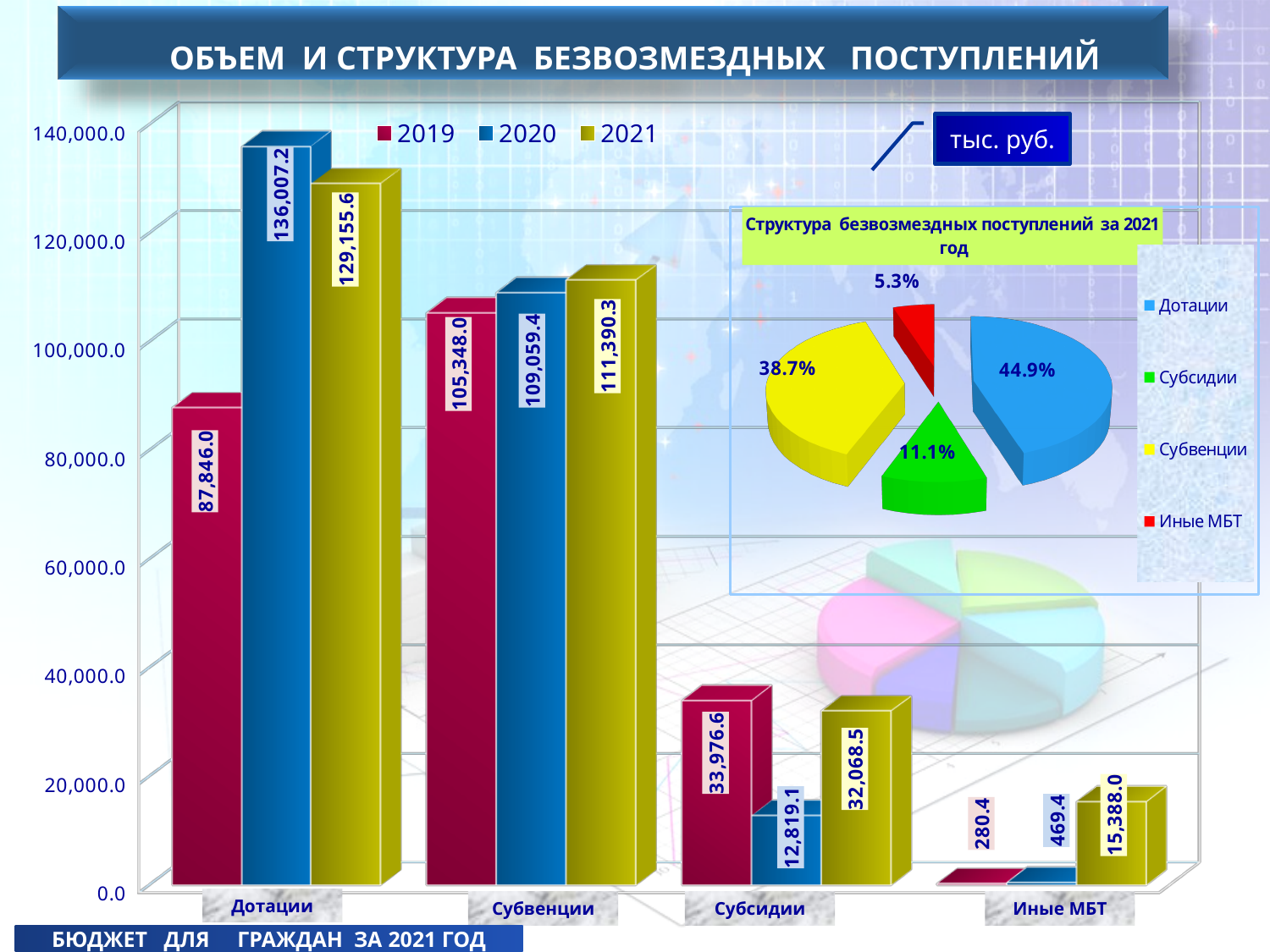
In the bar chart, how many categories are shown on the x axis? 4 In the bar chart, what is the value for Дотации in 2020? 136,007.2 In the bar chart, which year has the highest value for Дотации? 2020 In the bar chart, what is the value for Иные МБТ in 2019? 280.4 In the bar chart, how many series does the legend list? 3 In the pie chart 'Структура безвозмездных поступлений за 2021 год', what share does Субвенции have? 38.7% In the bar chart, what is the value for Субсидии in 2021? 32,068.5 In the bar chart, which is larger for Субсидии: the 2019 value or the 2020 value? 2019 In the bar chart, what is the difference between the 2021 and 2019 values for Субвенции? 6,042.3 What unit is indicated for the values on the slide? тыс. руб. In the bar chart, which category has the lowest value in 2021? Иные МБТ In the pie chart 'Структура безвозмездных поступлений за 2021 год', which slice is the largest? Дотации